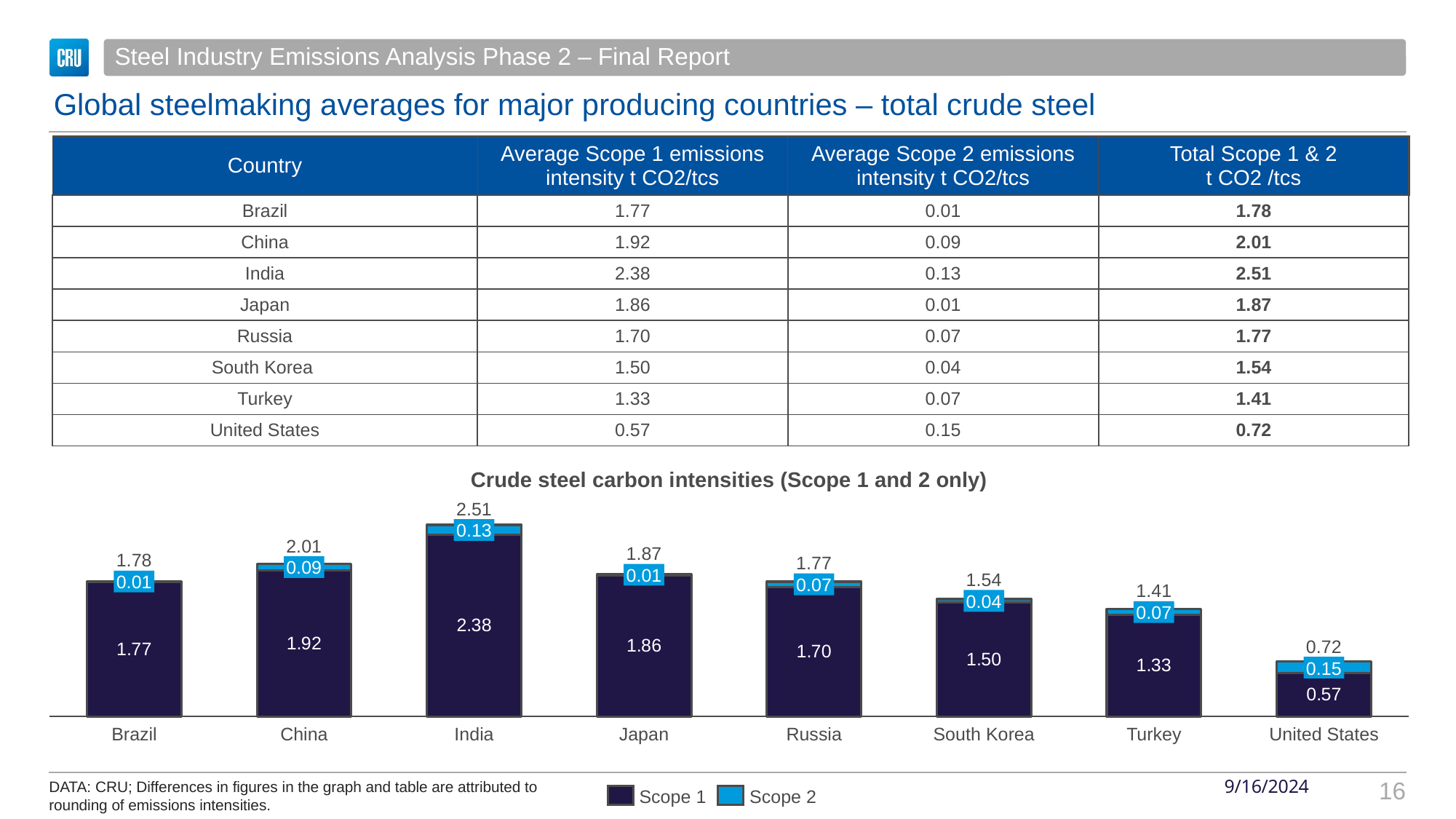
What kind of chart is shown on the slide? Stacked bar chart Which is larger, the Scope 1 value for Japan or for Russia? Japan What is the Scope 2 value for the United States in the chart? 0.15 Which country has the highest total stacked bar in the chart? India What is the total of the stacked bar for China? 2.01 What is the title of the chart? Crude steel carbon intensities (Scope 1 and 2 only) How many countries are shown on the x axis of the chart? 8 Which country has the lowest total stacked bar in the chart? United States What is the difference between the Scope 1 values for India and Turkey? 1.05 Which series is shown in light blue in the chart? Scope 2 What is the Scope 1 value for India in the chart? 2.38 How many series does the chart legend list? 2